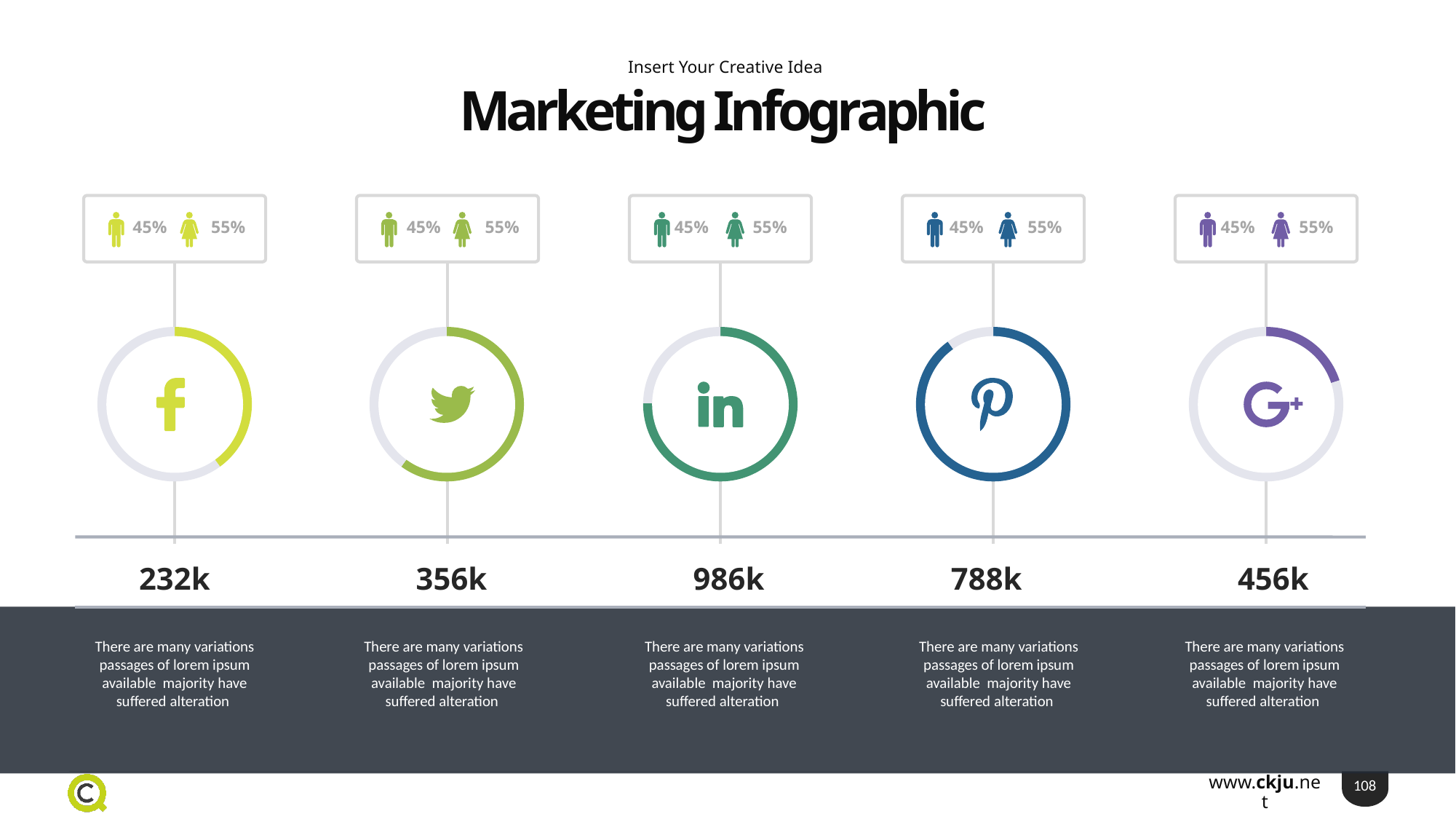
What value is shown below the LinkedIn ring chart? 986k What value is shown below the Facebook ring chart? 232k What is the main title of the slide? Marketing Infographic What value is shown below the Pinterest ring chart? 788k What percentage is shown for the female icon in the box above the Twitter ring chart? 55% What is the difference between the LinkedIn value and the Facebook value? 754k Which platform has the highest value shown below its ring chart? LinkedIn Which platform's ring is filled the most? Pinterest How many platform ring charts are shown on the slide? 5 Which is larger, the Twitter value or the Google+ value? Google+ Which platform has the lowest value shown below its ring chart? Facebook What value is shown below the Google+ ring chart? 456k